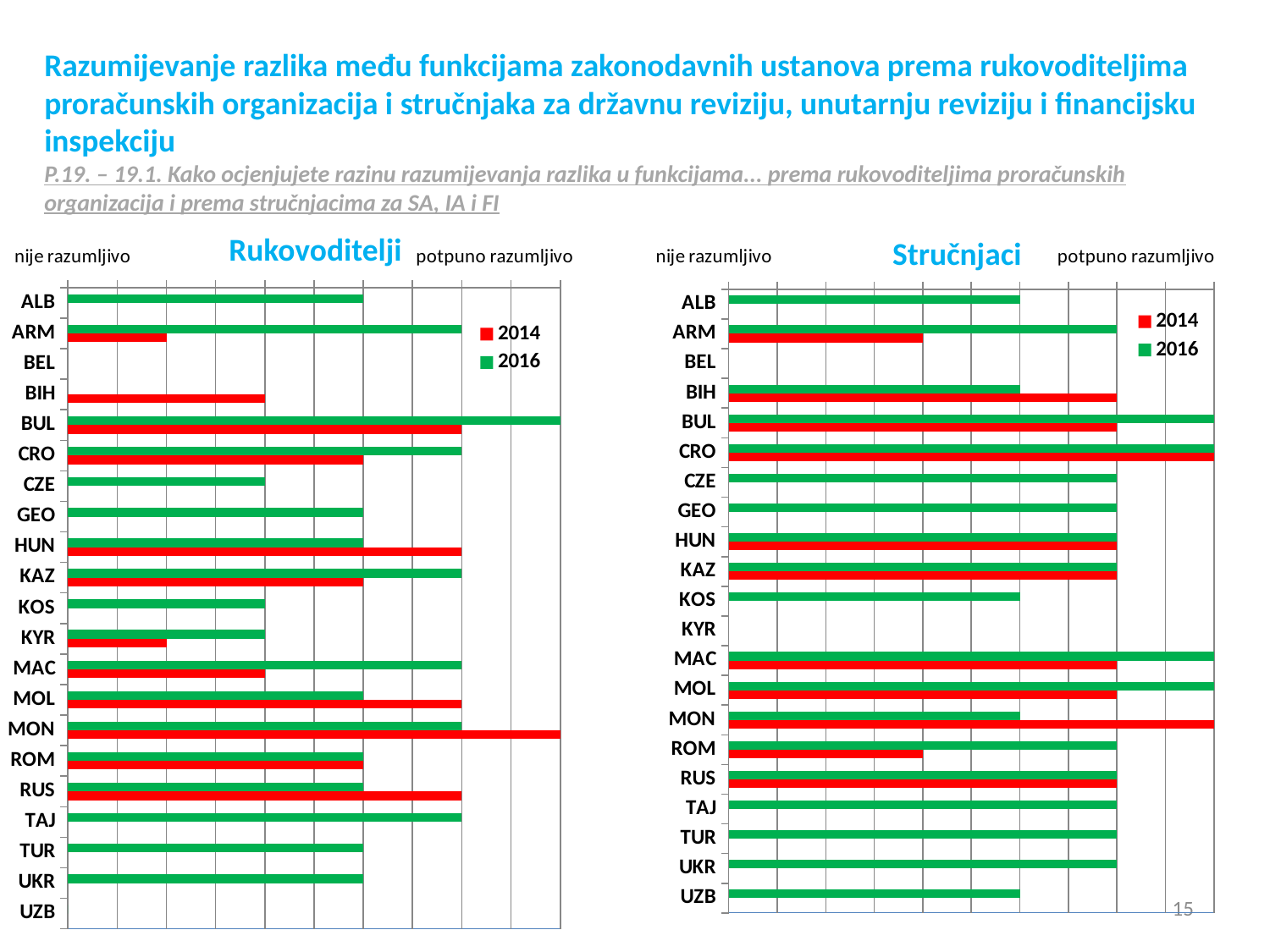
In the "Stručnjaci" chart, which colour represents 2016? green What kind of chart is the "Rukovoditelji" chart? bar chart In the "Rukovoditelji" chart, which country has the longest 2014 bar? MON In the "Stručnjaci" chart, which is larger for ROM, the 2014 value or the 2016 value? 2016 In the "Rukovoditelji" chart, which country has the shortest 2016 bar among those with a 2016 bar? CZE, KOS and KYR (tied) In the "Rukovoditelji" chart, which country has the longest 2016 bar? BUL In the "Rukovoditelji" chart, is the 2016 bar for ARM longer or shorter than its 2014 bar? longer In the "Stručnjaci" chart, which is larger for MON, the 2014 value or the 2016 value? 2014 How many country categories are listed on the "Stručnjaci" chart? 21 How many country categories are listed on the "Rukovoditelji" chart? 21 How many series does the legend of the "Stručnjaci" chart list? 2 What are the legend entries on the "Rukovoditelji" chart? 2014 and 2016